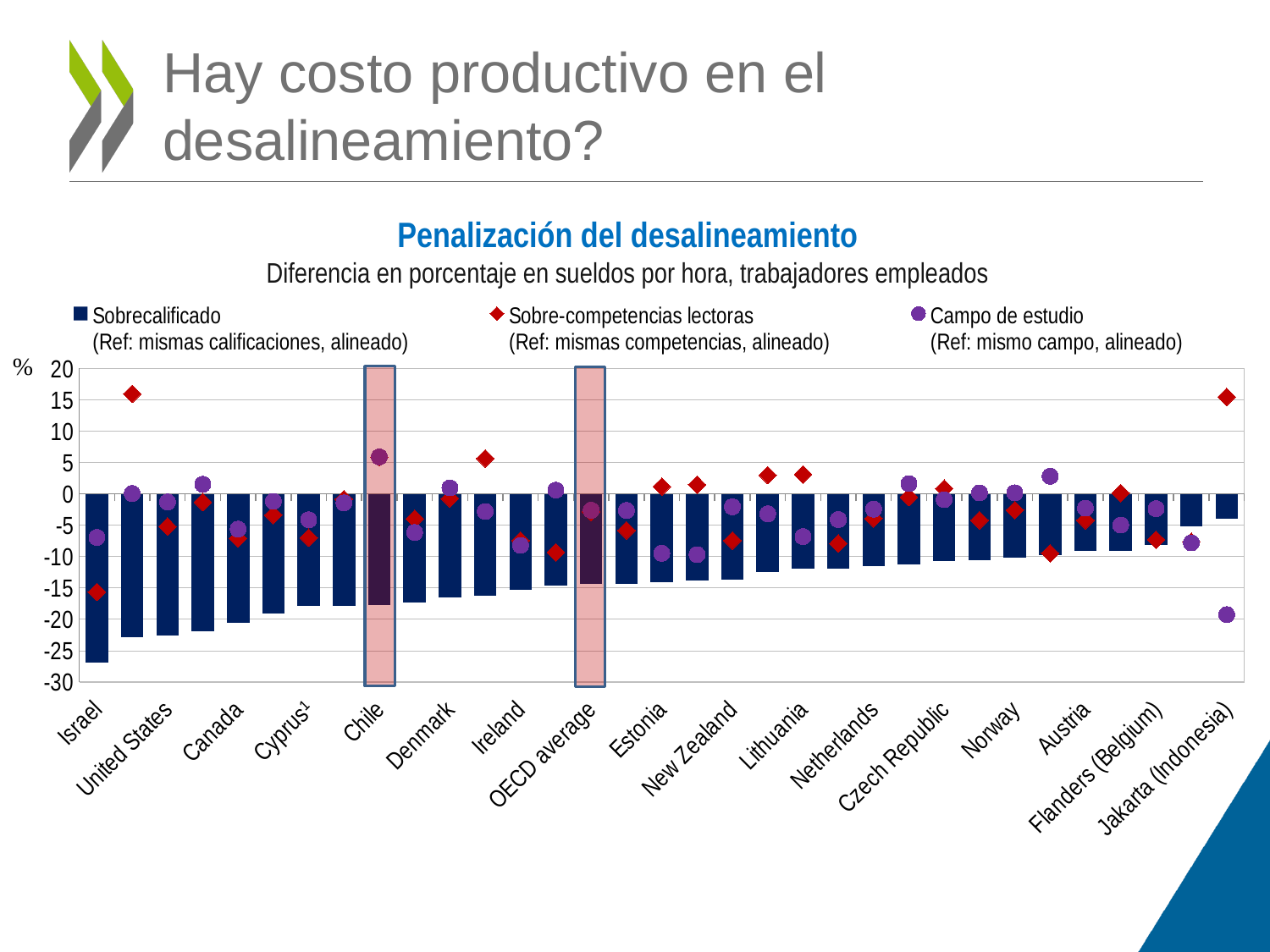
How many series does the legend list? 3 Is the Sobre-competencias lectoras value for United States greater or less than 10? less Which category has the lowest Campo de estudio marker? Jakarta (Indonesia) Do the Sobrecalificado bars rise or fall moving from left to right along the x axis? rise What is the title of the chart? Penalización del desalineamiento What kind of chart is shown on the slide? combination bar and line chart Which is larger, the Campo de estudio value for Chile or for Denmark? Chile Is the Sobrecalificado value for Chile greater or less than -15? less Which category has the lowest Sobrecalificado bar? Israel Which category has the highest Campo de estudio marker? Chile Is the Sobrecalificado value for Israel greater or less than -25? less Which two categories are highlighted with shaded boxes on the chart? Chile and OECD average